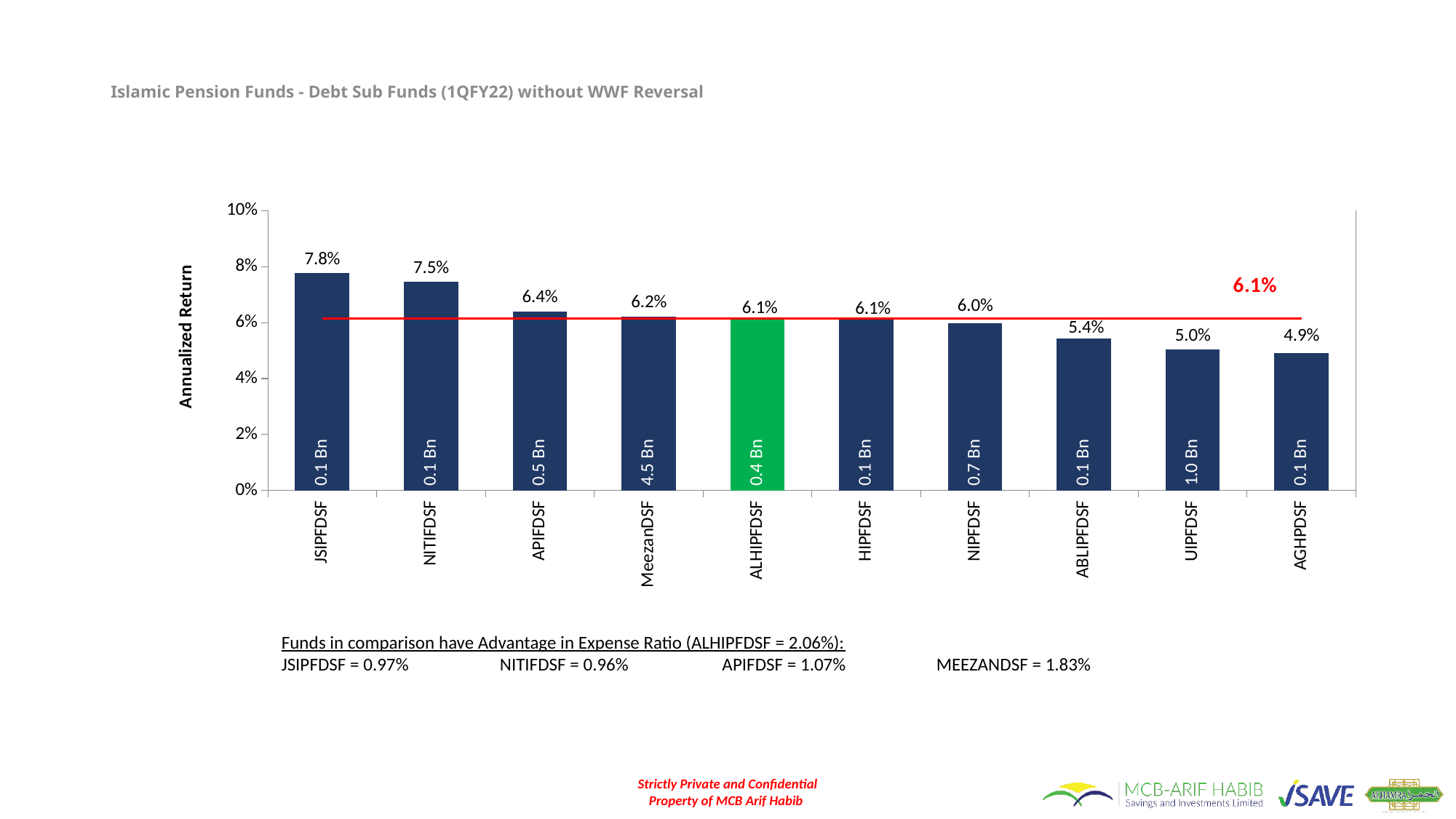
What fund size is printed inside the MeezanDSF bar? 4.5 Bn What type of chart is shown on the slide? bar chart What value is labelled on the red horizontal line? 6.1% Which fund has the lowest annualized return? AGHPDSF Which has a higher annualized return, APIFDSF or UIPFDSF? APIFDSF What is the annualized return for JSIPFDSF? 7.8% What is the annualized return for AGHPDSF? 4.9% Is the annualized return for ABLIPFDSF greater or less than 6%? less What is the annualized return for ALHIPFDSF? 6.1% Which fund has the highest annualized return? JSIPFDSF What is the difference in annualized return between JSIPFDSF and NITIFDSF? 0.3% How many funds are shown in the chart? 10